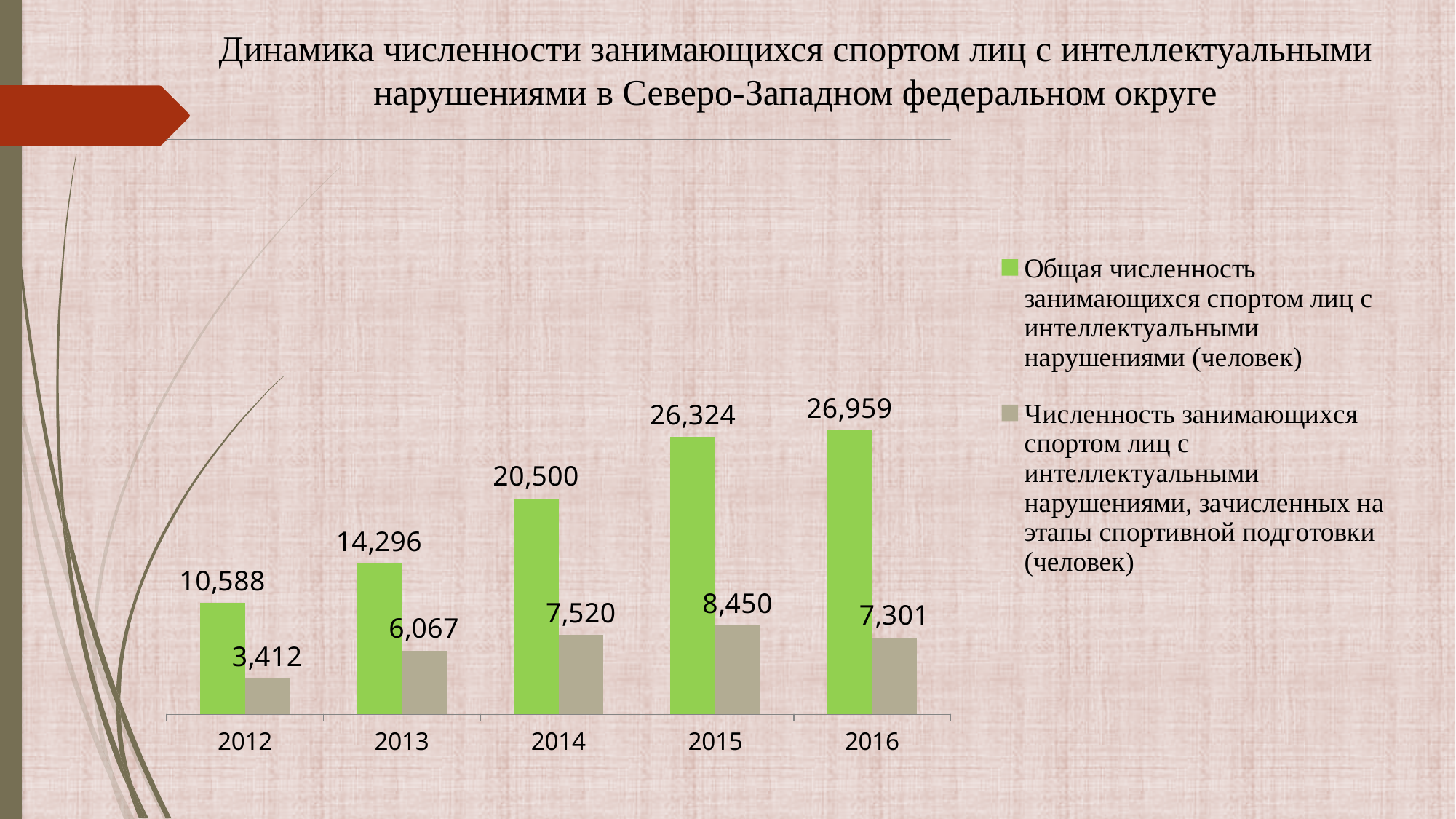
What colour are the bars for the 'Общая численность занимающихся спортом лиц с интеллектуальными нарушениями (человек)' series? green Does the 'Общая численность' (green) series rise or fall from 2012 to 2016? rise What is the difference between the 'Общая численность' (green) value and the 'зачисленных на этапы спортивной подготовки' (grey) value in 2013? 8,229 In which year is the 'Общая численность' (green) series lowest? 2012 What kind of chart is shown on the slide? bar chart In which year is the 'Численность ... зачисленных на этапы спортивной подготовки' (grey) series highest? 2015 What is the value of the 'Численность занимающихся спортом лиц с интеллектуальными нарушениями, зачисленных на этапы спортивной подготовки (человек)' series for 2012? 3,412 What is the value of the 'Общая численность' (green) series for 2016? 26,959 What is the value of the 'Общая численность занимающихся спортом лиц с интеллектуальными нарушениями (человек)' series for 2014? 20,500 Which is larger: the grey series value for 2014 or for 2016? 2014 How many series does the legend list? 2 How many years are shown on the x axis? 5